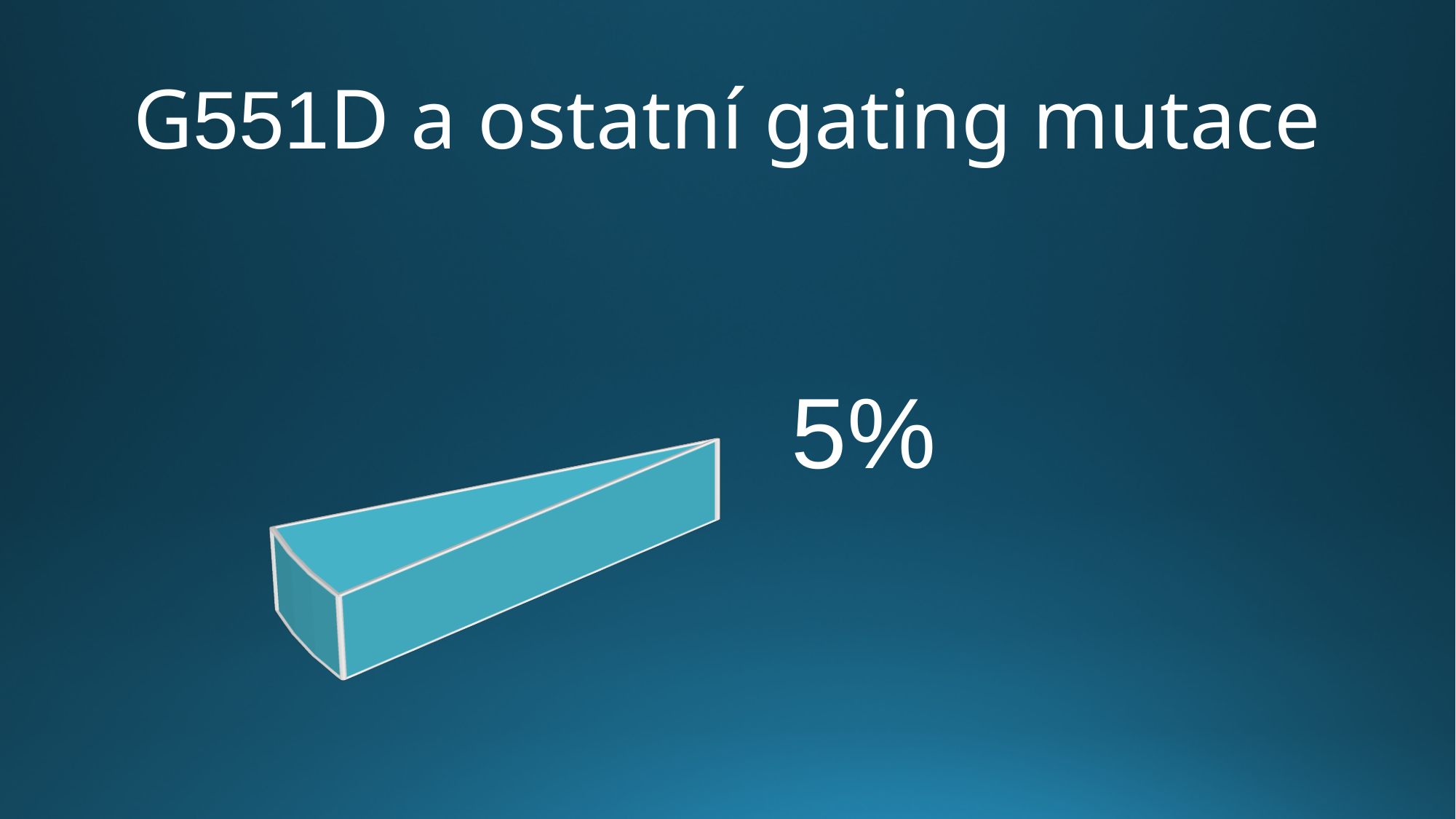
What colour is the pie slice shown on the slide? blue What share of the pie does the visible slice represent? 5% What kind of chart is shown on the slide? pie chart What is the title of the slide containing the chart? G551D a ostatní gating mutace How many pie slices are visible on the slide? 1 What value is printed next to the pie slice on the slide? 5%